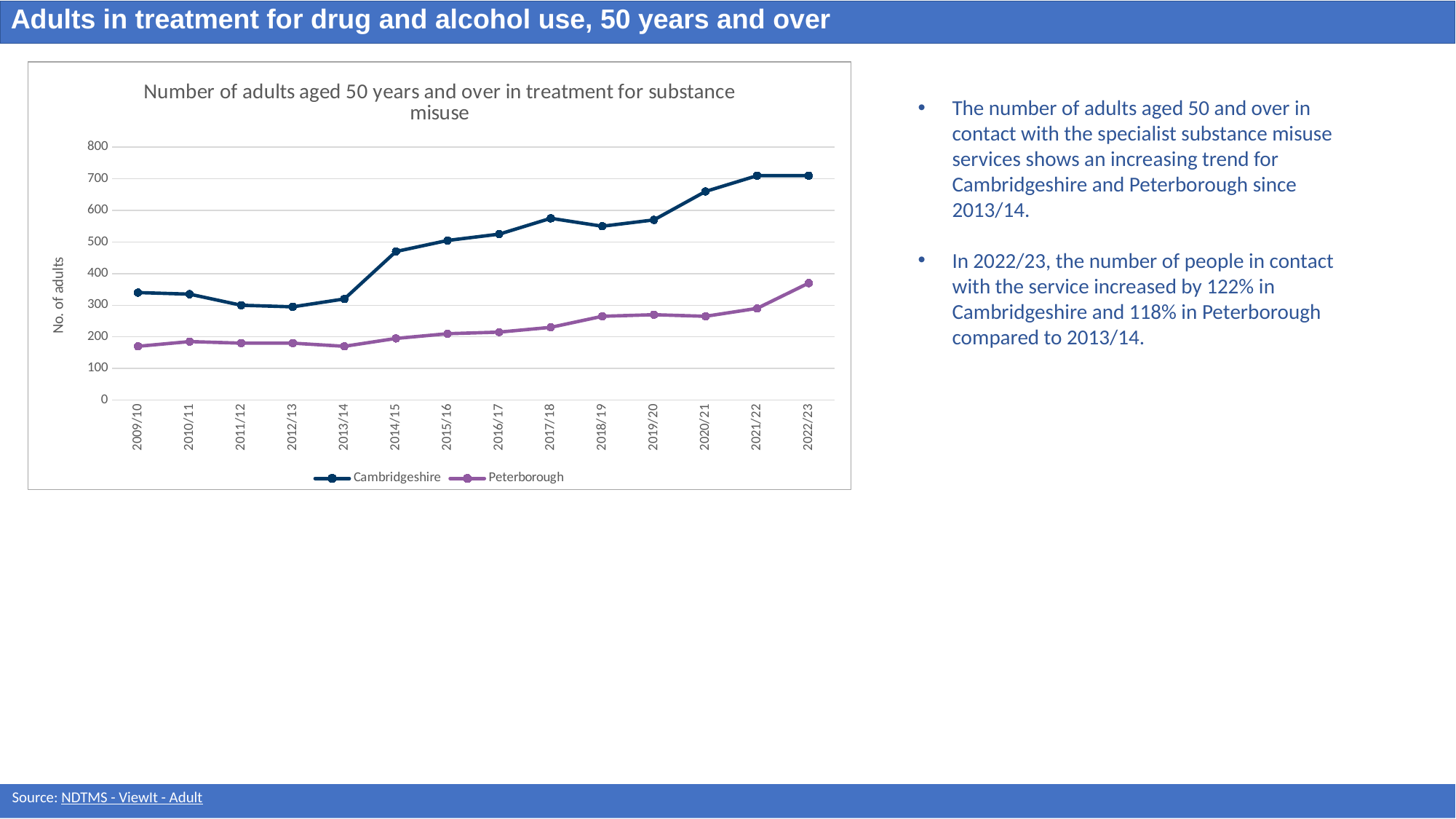
In which year does the Peterborough series reach its highest value? 2022/23 Is the value for Cambridgeshire in 2014/15 greater or less than 400? greater What is the label on the vertical axis of the chart? No. of adults How many series does the chart's legend list? 2 Is the value for Cambridgeshire in 2020/21 greater or less than 600? greater Which series has the higher value in 2022/23, Cambridgeshire or Peterborough? Cambridgeshire What kind of chart is shown on the slide? Line chart Is the value for Peterborough in 2009/10 greater or less than 200? less Does the Cambridgeshire series rise or fall between 2013/14 and 2022/23? Rise Which is larger for Peterborough, the value in 2021/22 or the value in 2022/23? 2022/23 How many financial years are plotted along the x axis of the chart? 14